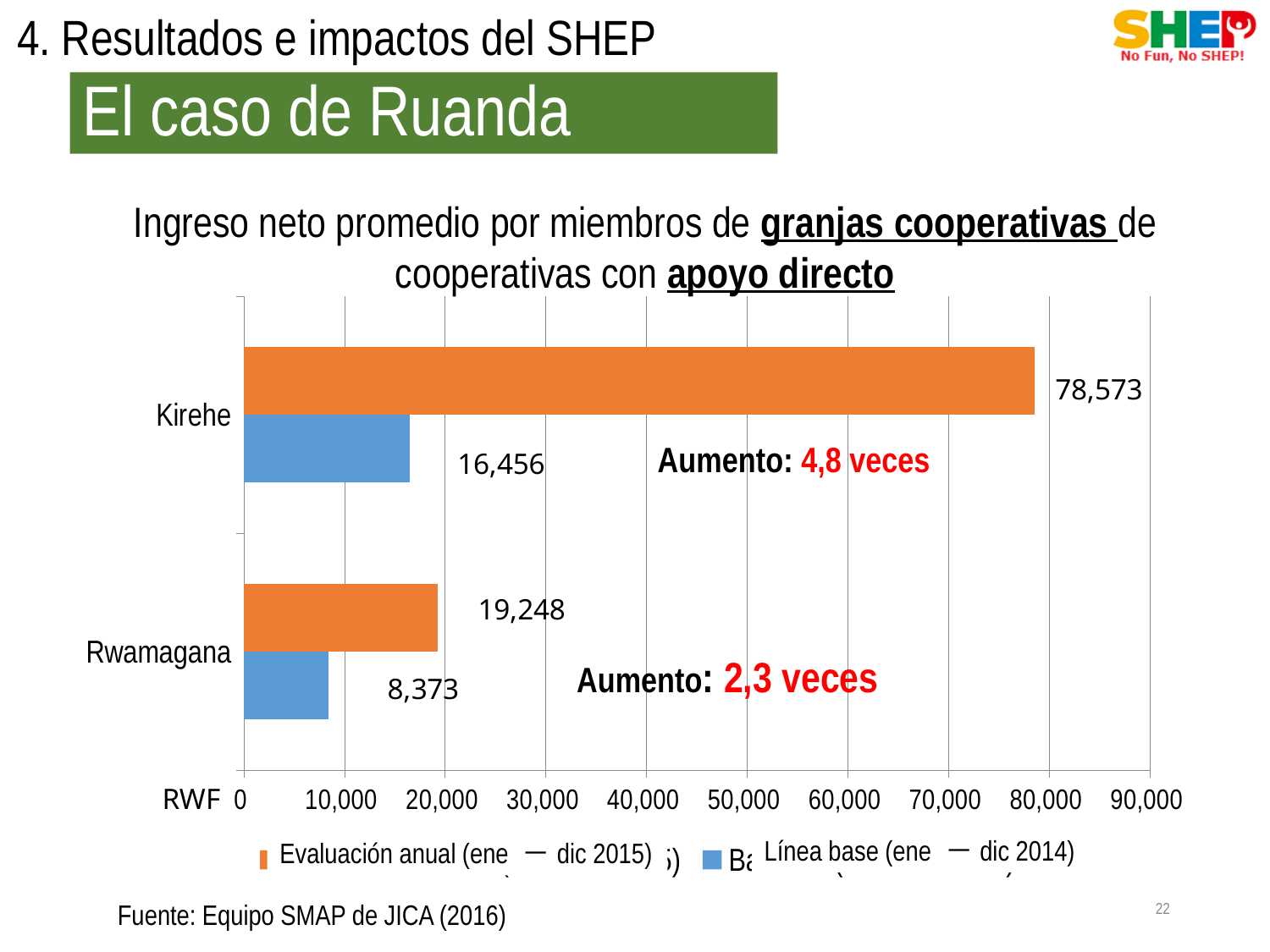
What kind of chart is shown on the slide? Bar chart Which category has the lowest value in the Línea base (ene – dic 2014) series? Rwamagana What is the value for Rwamagana in the Evaluación anual (ene – dic 2015) series? 19,248 What is the difference between the Evaluación anual and Línea base values for Rwamagana? 10,875 What is the value for Kirehe in the Evaluación anual (ene – dic 2015) series? 78,573 Which category has the highest value in the Evaluación anual (ene – dic 2015) series? Kirehe How many categories are shown on the chart? 2 What is the difference between the Evaluación anual and Línea base values for Kirehe? 62,117 What is the value for Rwamagana in the Línea base (ene – dic 2014) series? 8,373 How many series does the legend list? 2 What is the value for Kirehe in the Línea base (ene – dic 2014) series? 16,456 Which is larger: the Línea base value for Kirehe or the Evaluación anual value for Rwamagana? Evaluación anual value for Rwamagana